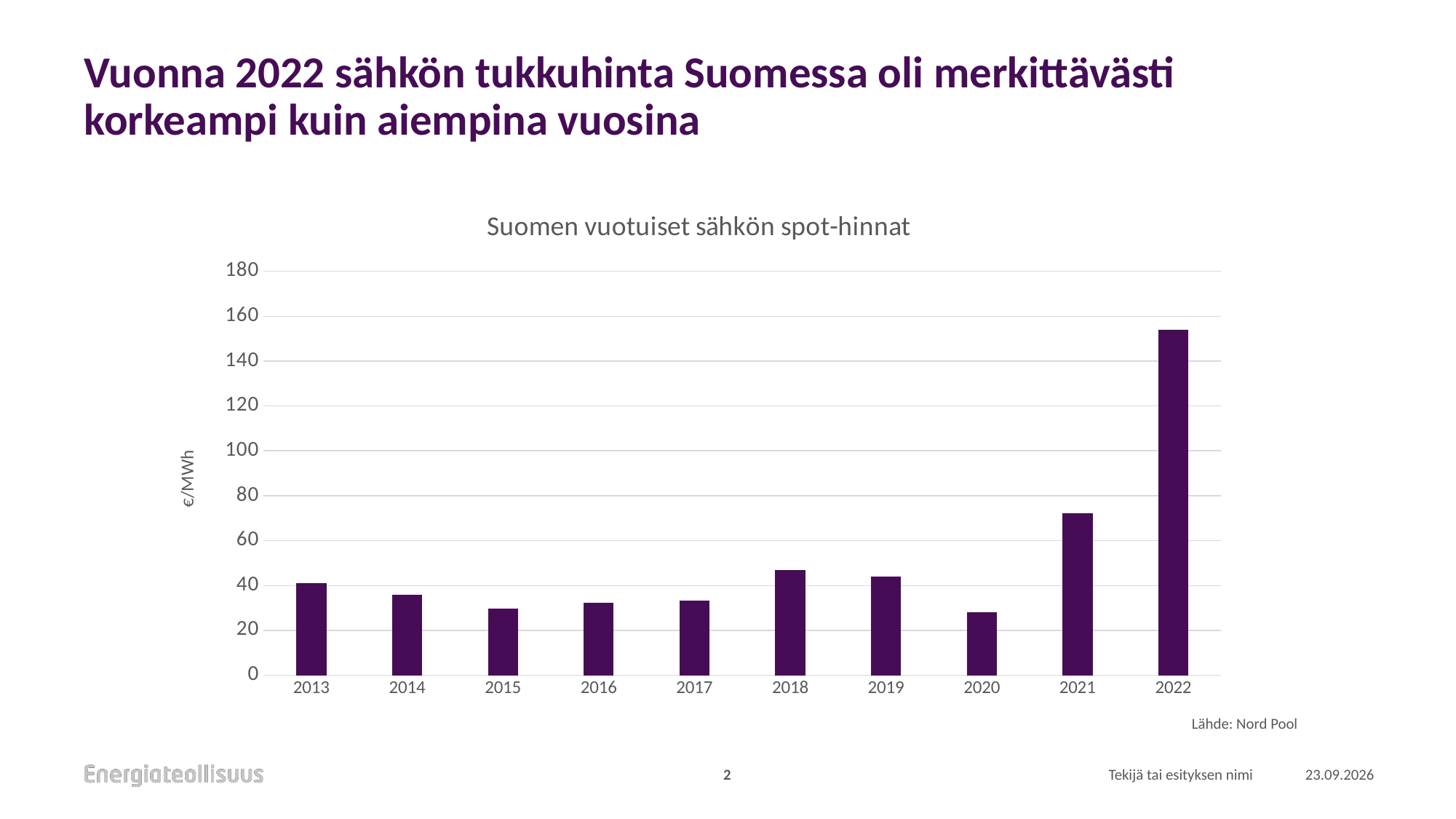
How many years are shown on the x axis of the chart? 10 Which is larger, the value for 2013 or the value for 2014? 2013 Is the value for 2020 greater or less than 40? less Is the value for 2021 greater or less than 80? less Is the value for 2022 greater or less than 140? greater What type of chart is shown on the slide? Bar chart Which year has the highest spot price in the chart? 2022 What is the title of the chart? Suomen vuotuiset sähkön spot-hinnat What unit is shown on the vertical axis of the chart? €/MWh Which is larger, the value for 2021 or the value for 2013? 2021